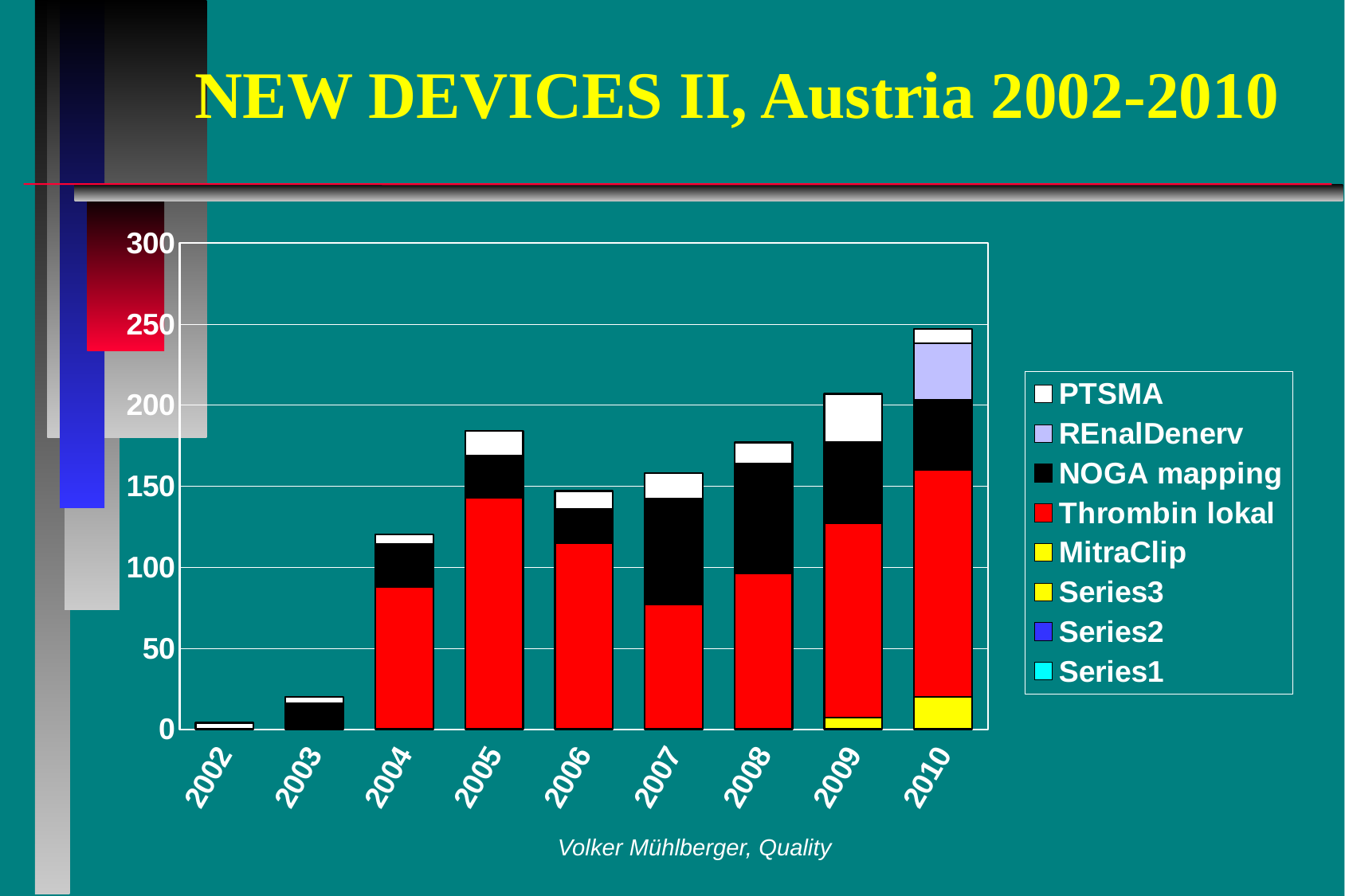
How many years are shown along the x axis of the chart? 9 Is the total for 2002 greater or less than 50? less Is the total for 2010 greater or less than 200? greater Which year has the larger total, 2005 or 2006? 2005 Which year has the tallest stacked bar? 2010 Do the bar totals generally rise or fall from 2002 to 2010? rise Which year has the shortest stacked bar? 2002 What kind of chart is shown on the slide? Stacked bar chart How many series does the legend list? 8 What is the title of the slide? NEW DEVICES II, Austria 2002-2010 Is the total for 2008 greater or less than 150? greater